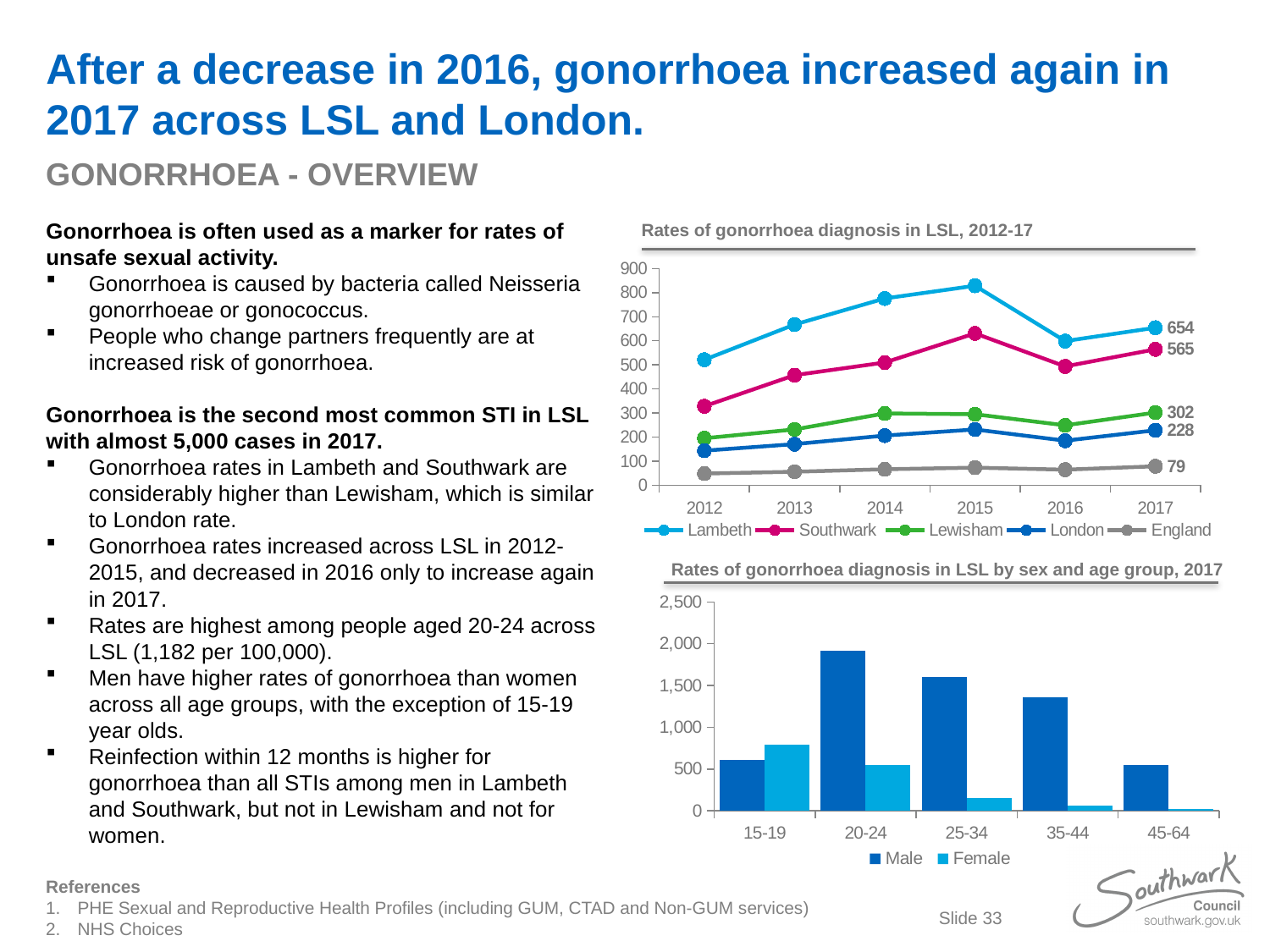
In the chart 'Rates of gonorrhoea diagnosis in LSL, 2012-17', did the Lambeth rate rise or fall between 2015 and 2016? fall In the chart 'Rates of gonorrhoea diagnosis in LSL, 2012-17', what is the difference between the Lewisham and London values in 2017? 74 In the chart 'Rates of gonorrhoea diagnosis in LSL, 2012-17', what is the value for Southwark in 2017? 565 In the chart 'Rates of gonorrhoea diagnosis in LSL, 2012-17', what is the difference between the Lambeth and Southwark values in 2017? 89 In the chart 'Rates of gonorrhoea diagnosis in LSL by sex and age group, 2017', which age group has the highest Male value? 20-24 In the chart 'Rates of gonorrhoea diagnosis in LSL by sex and age group, 2017', is the Male value for 20-24 greater or less than 1,500? greater In the chart 'Rates of gonorrhoea diagnosis in LSL, 2012-17', which series has the highest value in 2017? Lambeth In the chart 'Rates of gonorrhoea diagnosis in LSL, 2012-17', is the value for Lambeth in 2015 greater or less than 700? greater In the chart 'Rates of gonorrhoea diagnosis in LSL, 2012-17', how many series does the legend list? 5 In the chart 'Rates of gonorrhoea diagnosis in LSL, 2012-17', what is the value for Lambeth in 2017? 654 In the chart 'Rates of gonorrhoea diagnosis in LSL, 2012-17', what is the value for England in 2017? 79 What kind of chart is 'Rates of gonorrhoea diagnosis in LSL by sex and age group, 2017'? bar chart